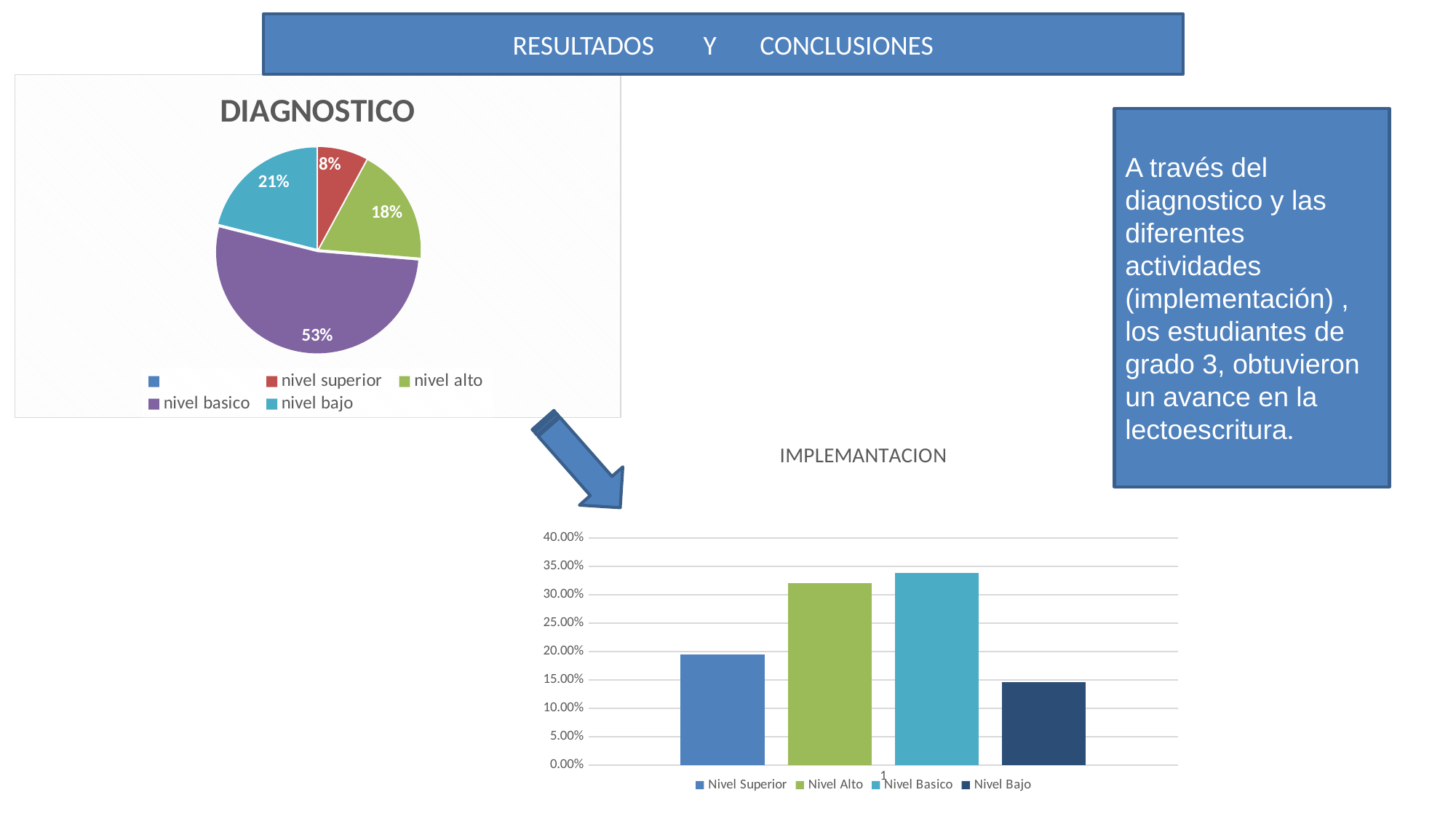
In the DIAGNOSTICO pie chart, what percentage is shown for nivel bajo? 21% In the DIAGNOSTICO pie chart, which category has the smallest slice? nivel superior In the DIAGNOSTICO pie chart, what percentage is shown for nivel basico? 53% In the DIAGNOSTICO pie chart, what percentage is shown for nivel superior? 8% In the IMPLEMANTACION chart, which category has the lowest bar? Nivel Bajo In the DIAGNOSTICO pie chart, which category has the largest slice? nivel basico What kind of chart is the IMPLEMANTACION chart? bar chart In the DIAGNOSTICO pie chart, what is the difference between the nivel bajo and nivel alto percentages? 3% How many entries does the legend of the IMPLEMANTACION chart list? 4 What kind of chart is the DIAGNOSTICO chart? pie chart In the DIAGNOSTICO pie chart, which is larger, nivel alto or nivel bajo? nivel bajo